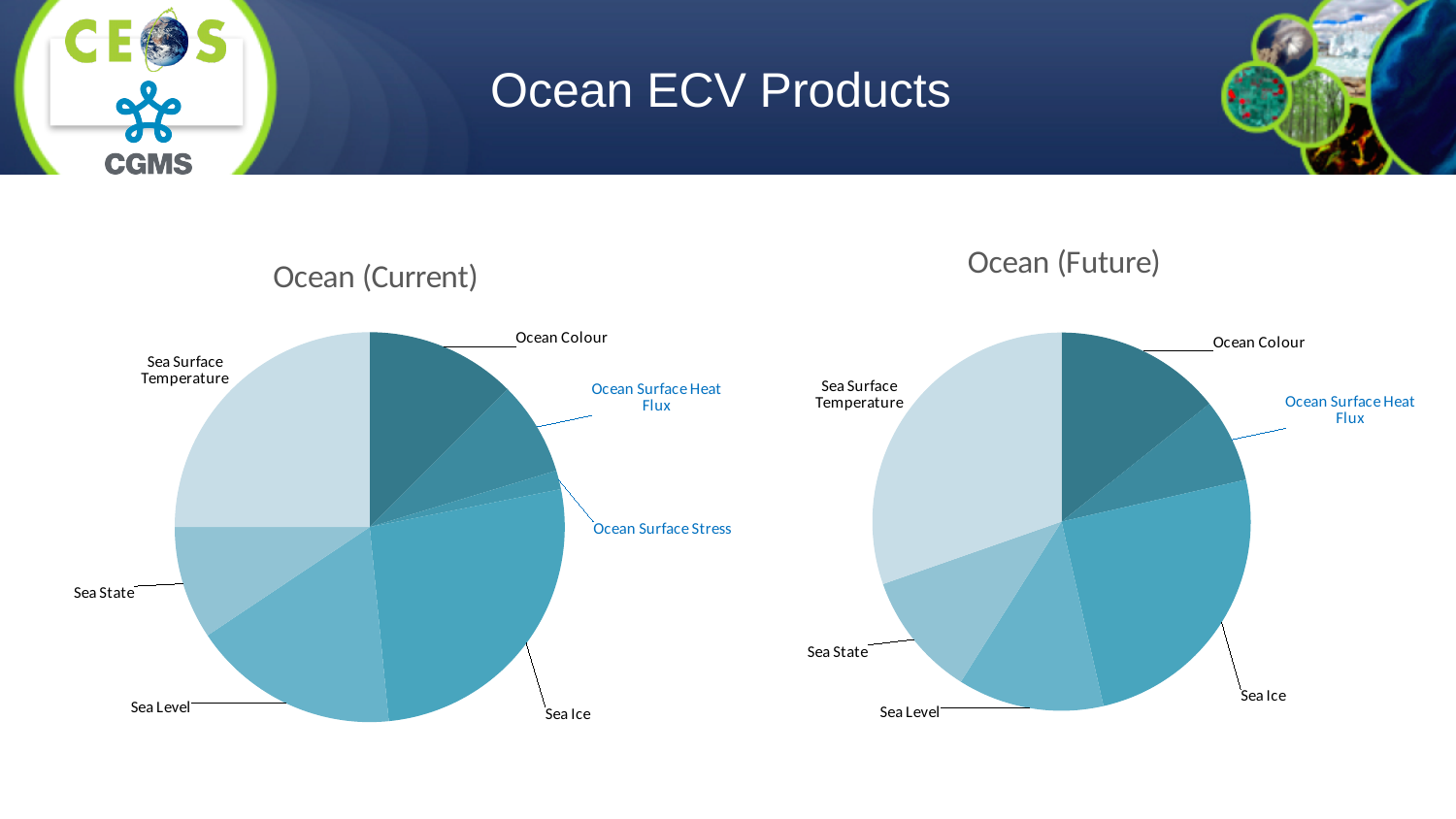
In the Ocean (Current) chart, which slice is the smallest? Ocean Surface Stress Which category appears in the Ocean (Current) chart but not in the Ocean (Future) chart? Ocean Surface Stress In the Ocean (Current) chart, which slice is larger, Sea Ice or Ocean Surface Stress? Sea Ice How many slices does the Ocean (Future) pie chart have? 6 What kind of chart is the Ocean (Current) chart? Pie chart In the Ocean (Current) chart, which slice is larger, Sea Level or Sea State? Sea Level How many slices does the Ocean (Current) pie chart have? 7 In the Ocean (Future) chart, which slice is larger, Sea Surface Temperature or Sea Level? Sea Surface Temperature What kind of chart is the Ocean (Future) chart? Pie chart What is the title of the pie chart on the right side of the slide? Ocean (Future) In the Ocean (Future) chart, which slice is the largest? Sea Surface Temperature